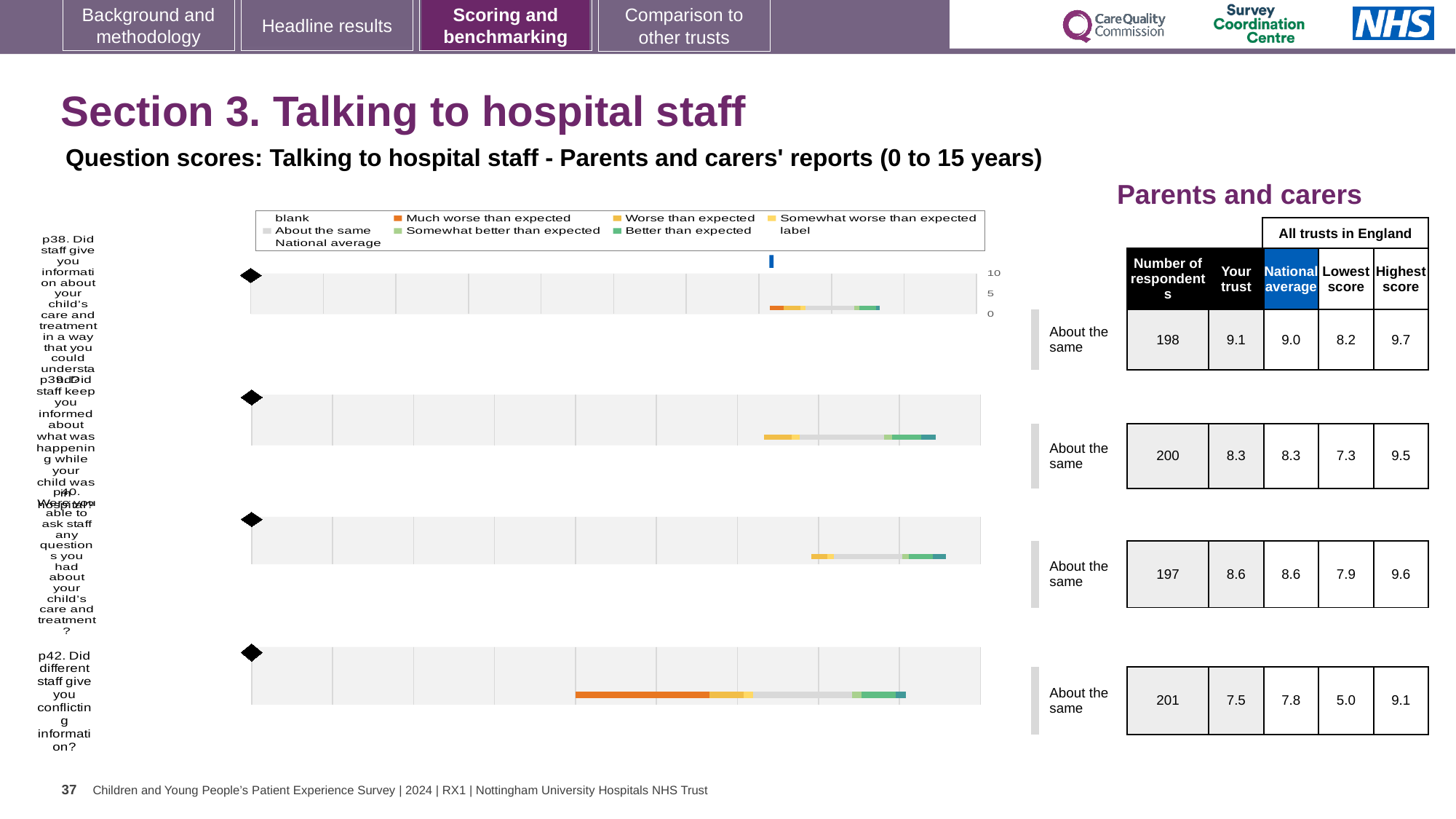
How many entries does the legend above the charts list? 9 Which question has the lowest 'Lowest score' value in the table? p42 For p42, what is the difference between the highest score and the lowest score in the table? 4.1 For p42, which is larger: the 'Your trust' score or the national average? National average What kind of chart is used to show the question scores on this slide? bar chart In the table, what is the national average for p39 (staff keeping you informed)? 8.3 How many question charts (rows) are shown on the slide? 4 In the table, what is the 'Your trust' score for p42 (different staff giving conflicting information)? 7.5 In the table, what is the number of respondents for p38 (information about your child's care and treatment)? 198 What benchmark category is shown next to the chart for p40 (able to ask staff any questions)? About the same What colour does the legend use for 'Much worse than expected'? orange Which question has the highest 'Your trust' score in the table? p38